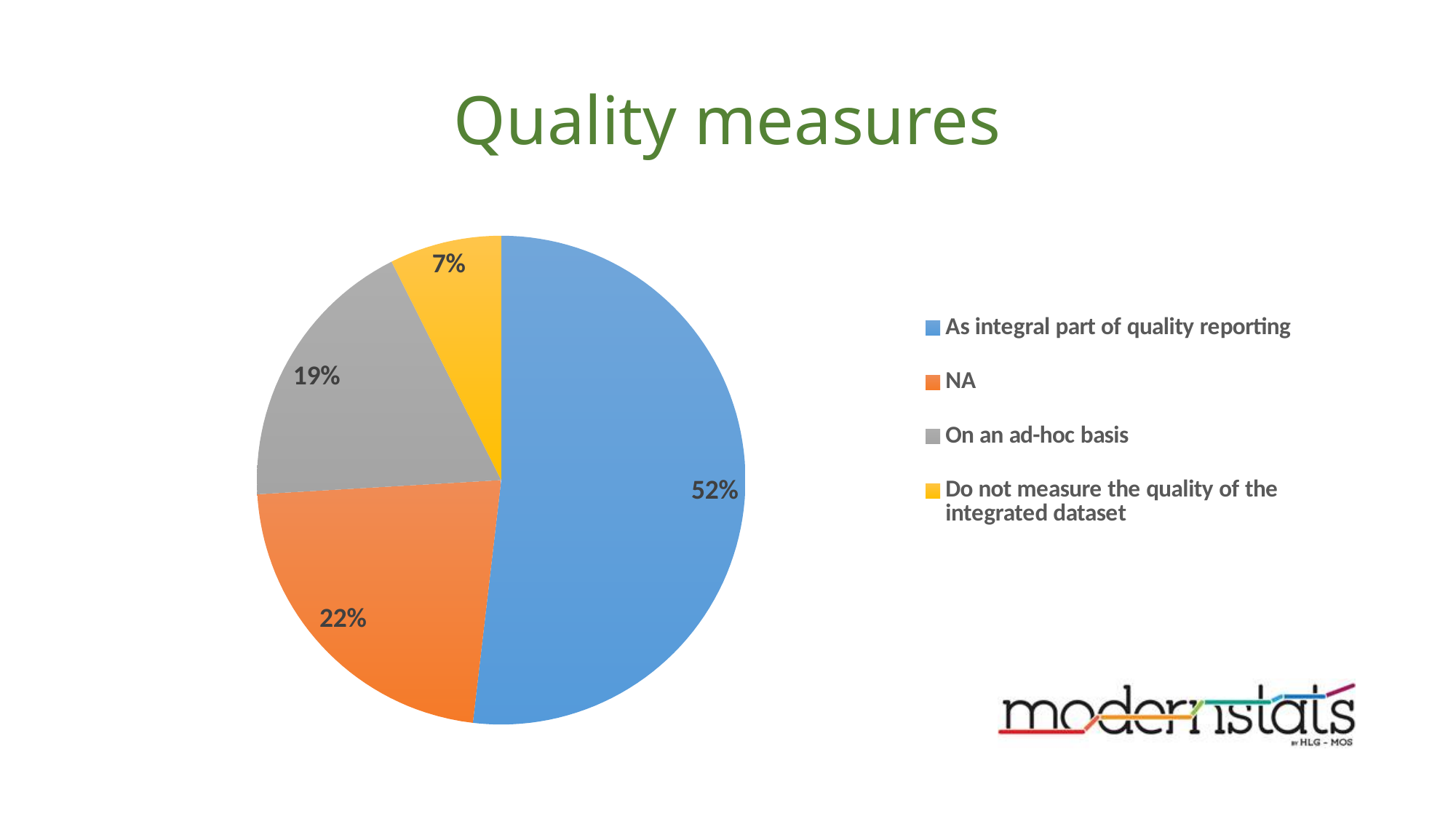
What share of the pie is 'NA'? 22% How many categories does the pie chart have? 4 What kind of chart is shown on the slide? pie chart What share of the pie is 'On an ad-hoc basis'? 19% Which is larger, the slice for 'NA' or the slice for 'On an ad-hoc basis'? NA What is the title of the slide? Quality measures What colour is the slice for 'On an ad-hoc basis'? grey Which category has the smallest slice of the pie? Do not measure the quality of the integrated dataset What is the difference in percentage points between 'As integral part of quality reporting' and 'NA'? 30 What share of the pie is 'Do not measure the quality of the integrated dataset'? 7% Which category has the largest slice of the pie? As integral part of quality reporting